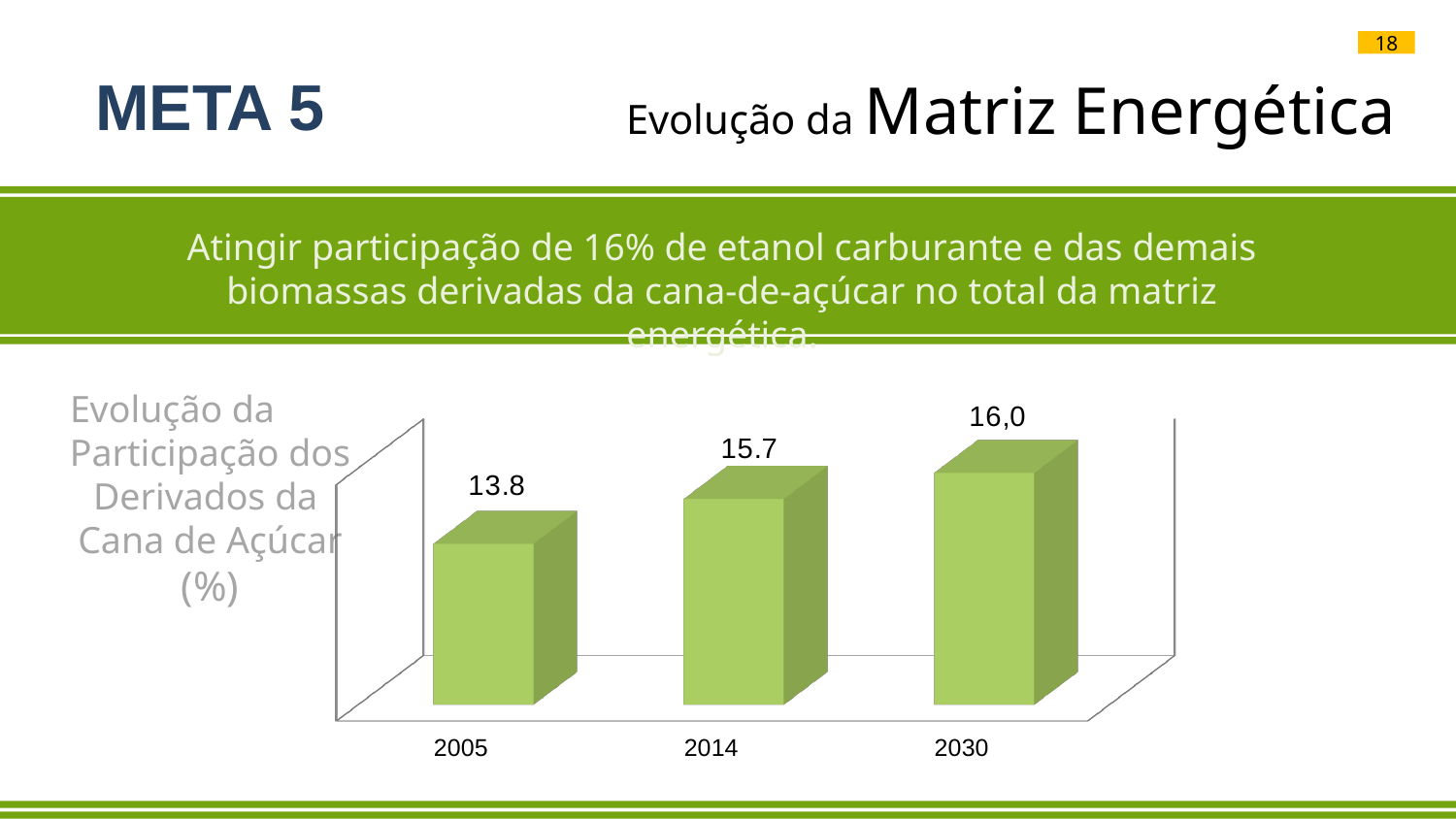
Which year has the lowest value? 2005 What is the value shown for 2030? 16,0 Which is larger, the value for 2005 or the value for 2014? 2014 What kind of chart is shown on the slide? Bar chart Which year has the highest value? 2030 What is the value shown for 2005? 13.8 Do the values rise or fall from 2005 to 2030? Rise How many years are shown on the chart? 3 What is the title of the chart? Evolução da Participação dos Derivados da Cana de Açúcar (%) What is the difference between the values for 2014 and 2005? 1.9 What is the value shown for 2014? 15.7 What is the difference between the values for 2030 and 2005? 2.2